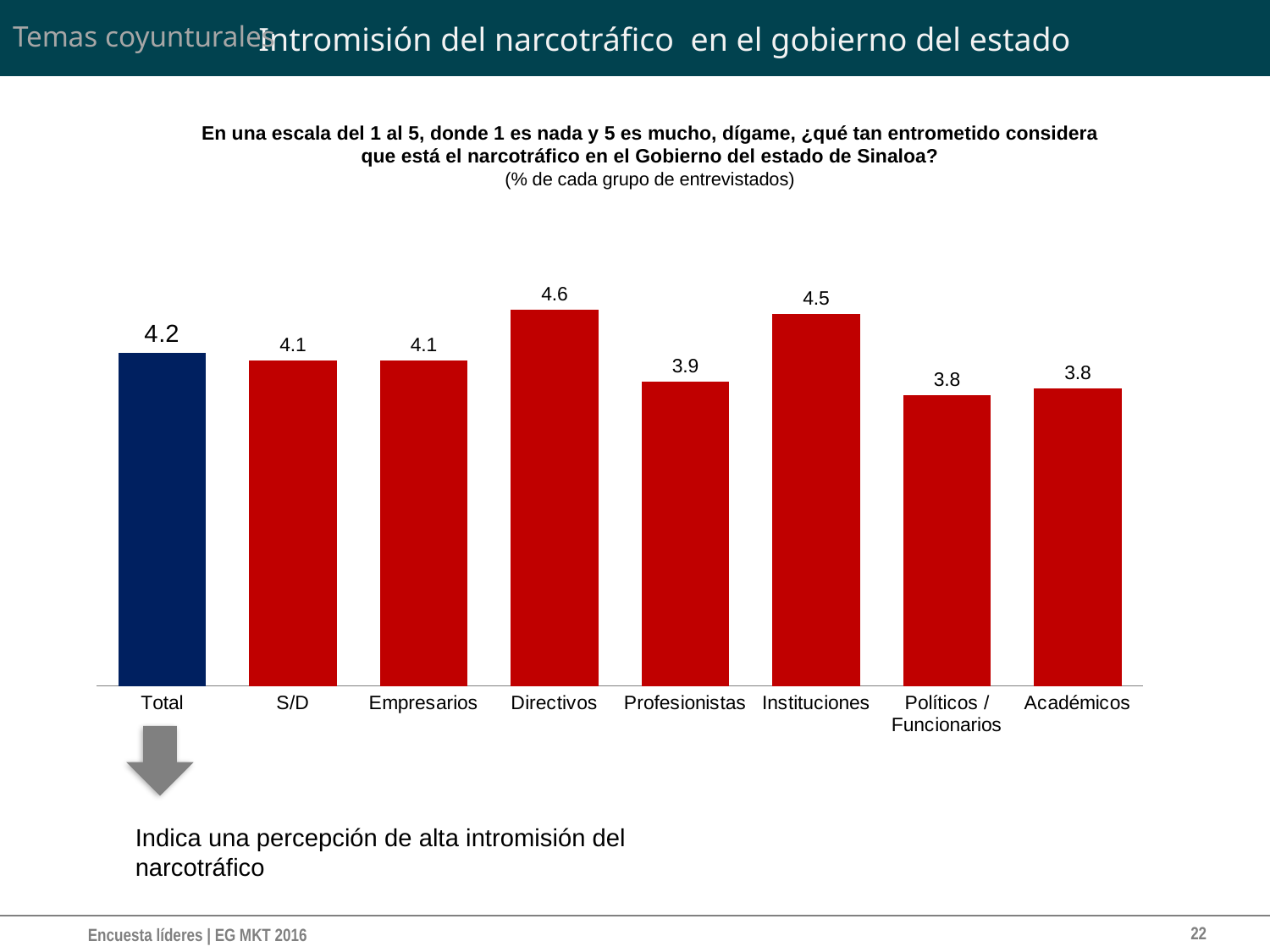
What is the value for Directivos? 4.6 Which is larger, the value for Total or the value for Políticos / Funcionarios? Total Which is larger, the value for Empresarios or the value for Directivos? Directivos What is the value for Instituciones? 4.5 Which category has the highest value? Directivos What is the value for Total? 4.2 What is the value for Profesionistas? 3.9 Which bar is coloured differently from the others? Total What is the difference between the values for Directivos and Profesionistas? 0.7 What kind of chart is shown on the slide? Bar chart What is the difference between the values for Instituciones and Académicos? 0.7 How many categories are shown on the x axis? 8